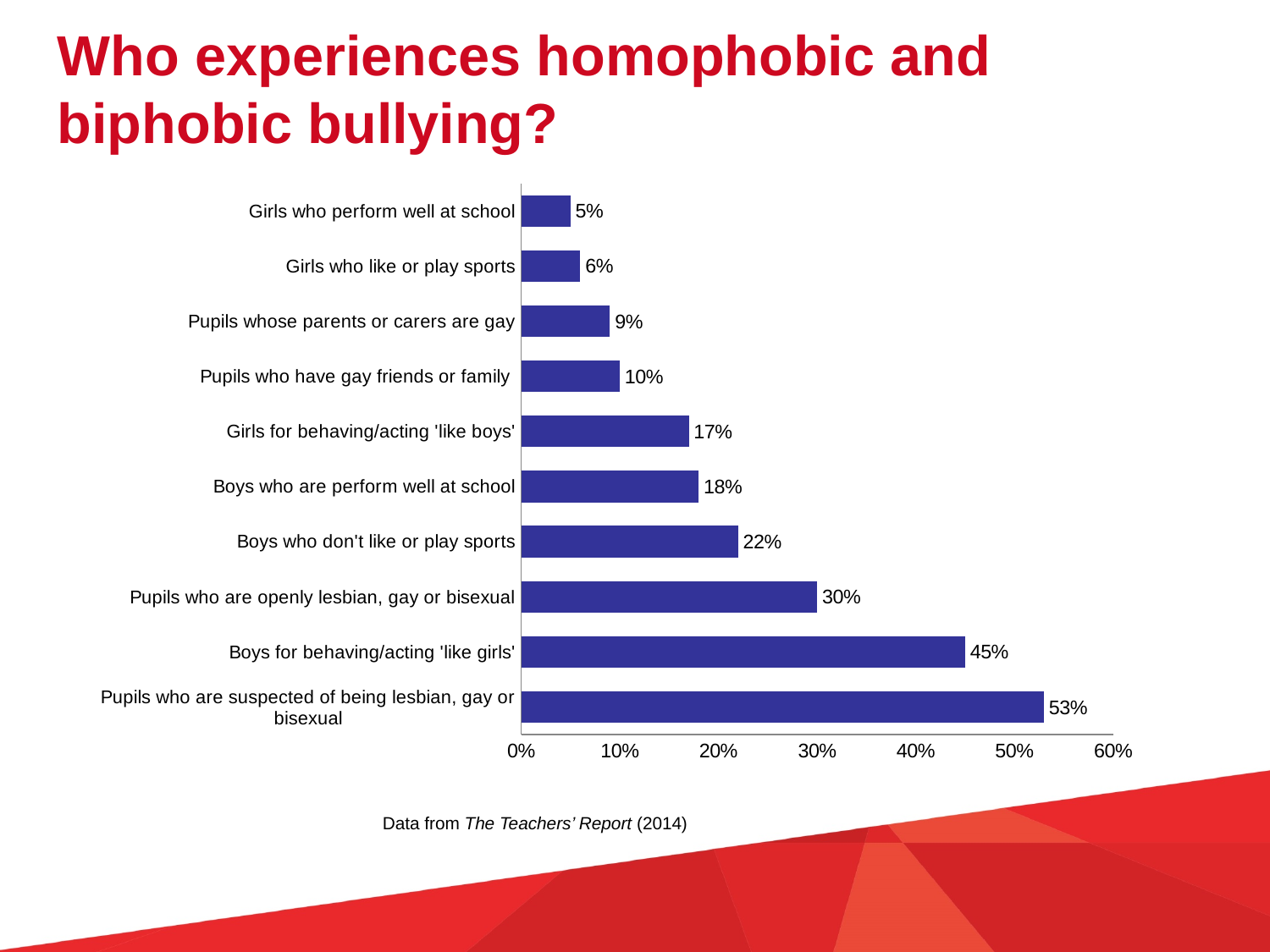
What is the value for 'Girls who like or play sports'? 6% What is the difference between the values for 'Pupils who are suspected of being lesbian, gay or bisexual' and 'Boys for behaving/acting 'like girls''? 8% Which is larger: the value for 'Girls for behaving/acting 'like boys'' or the value for 'Boys who are perform well at school'? Boys who are perform well at school What is the difference between the values for 'Boys who don't like or play sports' and 'Pupils who have gay friends or family'? 12% What is the value for 'Pupils who are openly lesbian, gay or bisexual'? 30% What is the value for 'Boys for behaving/acting 'like girls''? 45% Which category has the lowest value? Girls who perform well at school Which category has the highest value? Pupils who are suspected of being lesbian, gay or bisexual What kind of chart is shown on the slide? Bar chart How many categories are shown in the chart? 10 What is the source of the data cited below the chart? The Teachers' Report (2014) Is the value for 'Pupils who are openly lesbian, gay or bisexual' greater or less than 20%? greater